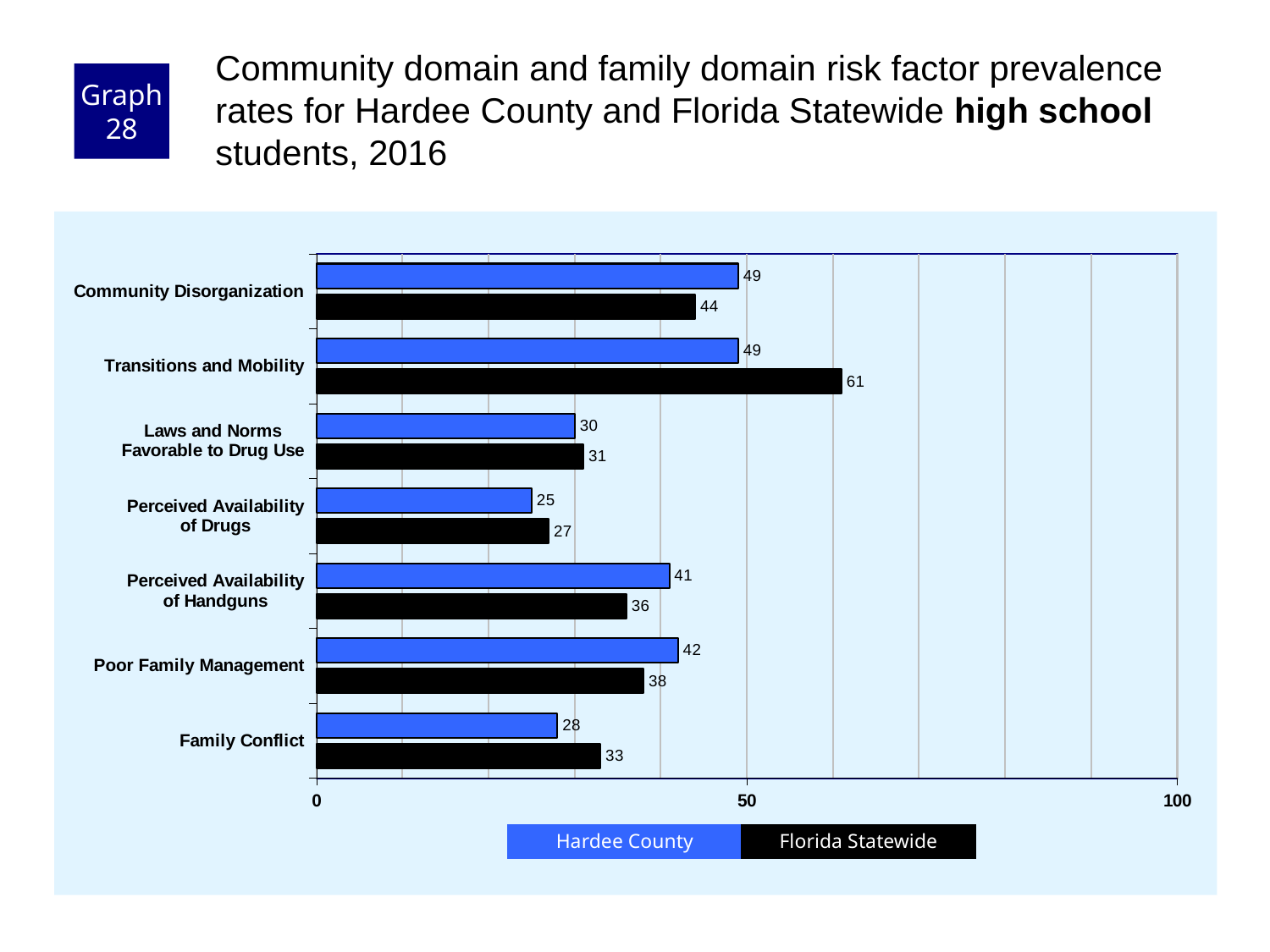
What is the difference between the Florida Statewide and Hardee County values for Transitions and Mobility? 12 What is the Florida Statewide value for Family Conflict? 33 How many series does the legend list? 2 Which risk factor has the highest Florida Statewide value? Transitions and Mobility What colour are the Florida Statewide bars? Black What kind of chart is shown on the slide? Bar chart Which risk factor has the lowest Hardee County value? Perceived Availability of Drugs What is the Hardee County value for Community Disorganization? 49 What is the Florida Statewide value for Transitions and Mobility? 61 For Poor Family Management, which is larger: the Hardee County value or the Florida Statewide value? Hardee County How many risk factor categories are shown on the chart? 7 What is the Hardee County value for Perceived Availability of Drugs? 25